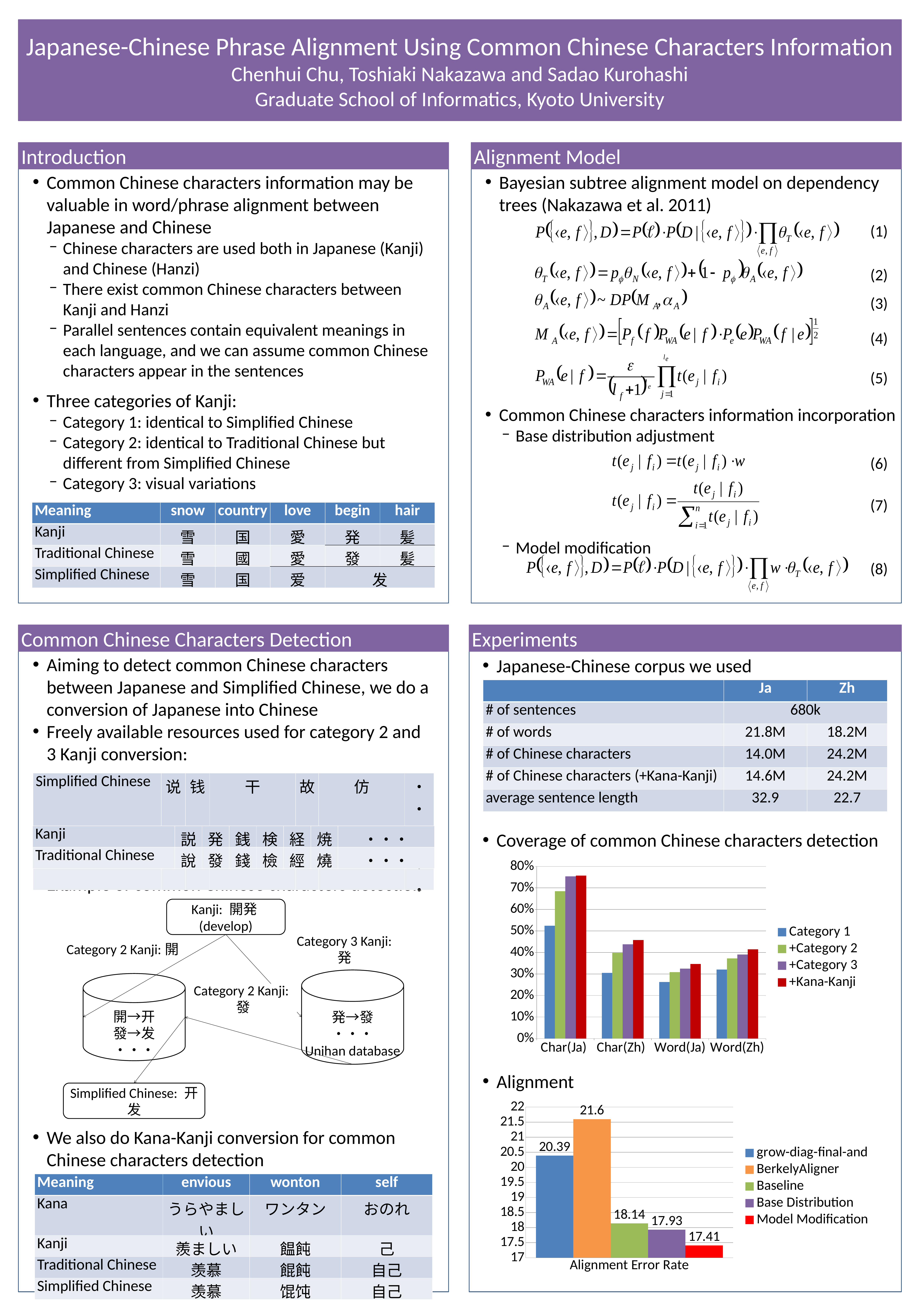
What kind of chart is the Coverage of common Chinese characters detection chart? bar chart In the Coverage of common Chinese characters detection chart, is the +Category 2 value for Char(Ja) greater or less than 60%? greater How many series does the legend of the Alignment chart list? 5 In the Alignment chart, which method has the highest Alignment Error Rate? BerkelyAligner In the Alignment chart, what is the difference between the Baseline value and the Model Modification value? 0.73 In the Alignment chart, what is the Alignment Error Rate for BerkelyAligner? 21.6 In the Alignment chart, what is the Alignment Error Rate for Model Modification? 17.41 In the Alignment chart, which is larger: grow-diag-final-and or Baseline? grow-diag-final-and In the Alignment chart, which method has the lowest Alignment Error Rate? Model Modification How many categories are shown on the x axis of the Coverage of common Chinese characters detection chart? 4 In the Coverage of common Chinese characters detection chart, is the Category 1 value for Char(Zh) greater or less than 40%? less In the Alignment chart, what is the value for Base Distribution? 17.93